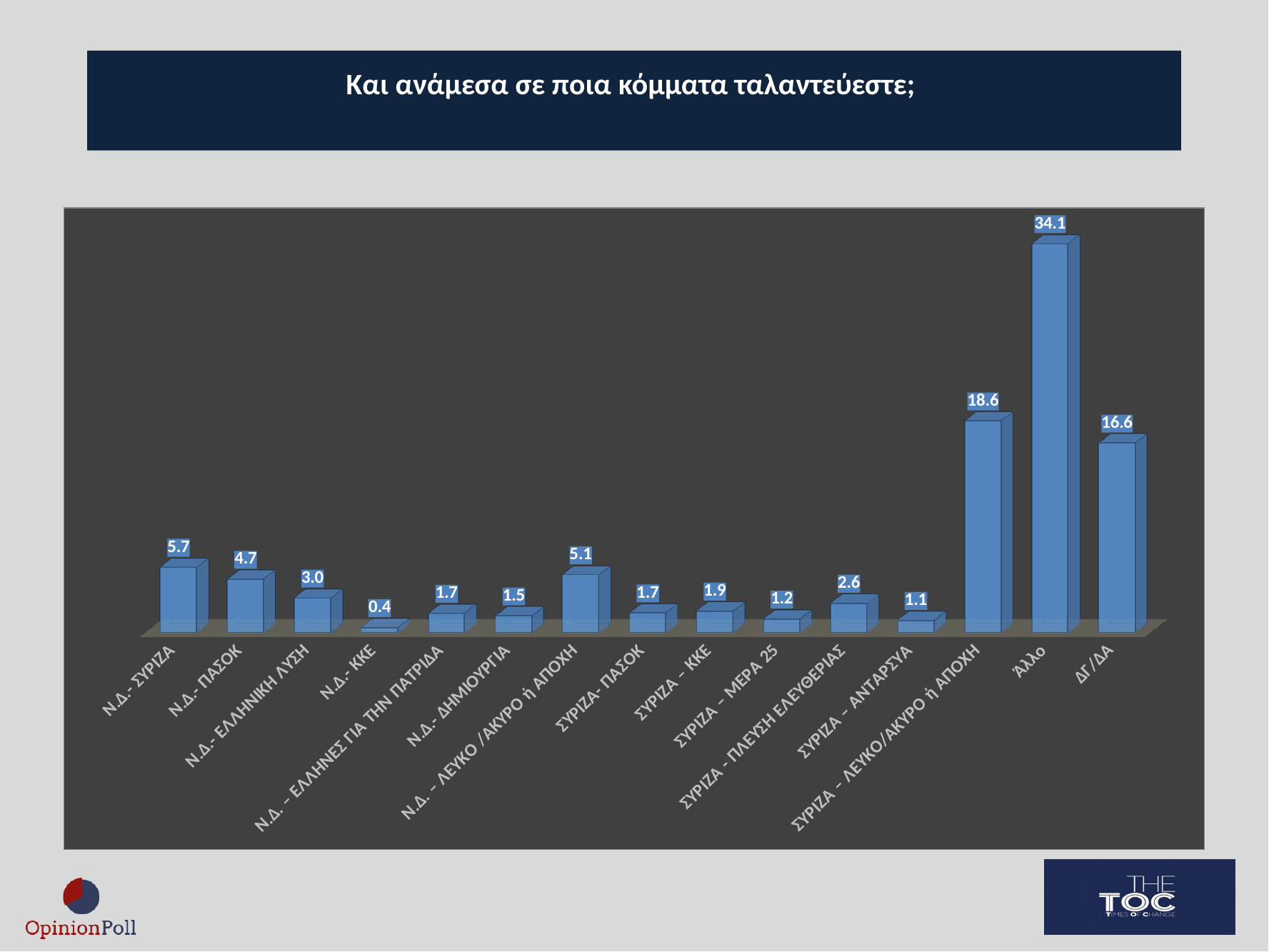
What kind of chart is shown on the slide? Bar chart Which category has the lowest value? Ν.Δ.- ΚΚΕ What is the difference between the values for Άλλο and ΣΥΡΙΖΑ – ΛΕΥΚΟ/ΑΚΥΡΟ ή ΑΠΟΧΗ? 15.5 Which category has the highest value? Άλλο What is the value for ΣΥΡΙΖΑ – ΛΕΥΚΟ/ΑΚΥΡΟ ή ΑΠΟΧΗ? 18.6 What is the difference between the values for Ν.Δ.- ΣΥΡΙΖΑ and Ν.Δ.- ΠΑΣΟΚ? 1.0 What is the value for Άλλο? 34.1 What is the value for Ν.Δ.- ΣΥΡΙΖΑ? 5.7 How many categories are shown on the chart? 15 Which is larger, the value for ΣΥΡΙΖΑ – ΛΕΥΚΟ/ΑΚΥΡΟ ή ΑΠΟΧΗ or the value for ΔΓ/ΔΑ? ΣΥΡΙΖΑ – ΛΕΥΚΟ/ΑΚΥΡΟ ή ΑΠΟΧΗ What is the title of the slide? Και ανάμεσα σε ποια κόμματα ταλαντεύεστε; What is the value for ΔΓ/ΔΑ? 16.6